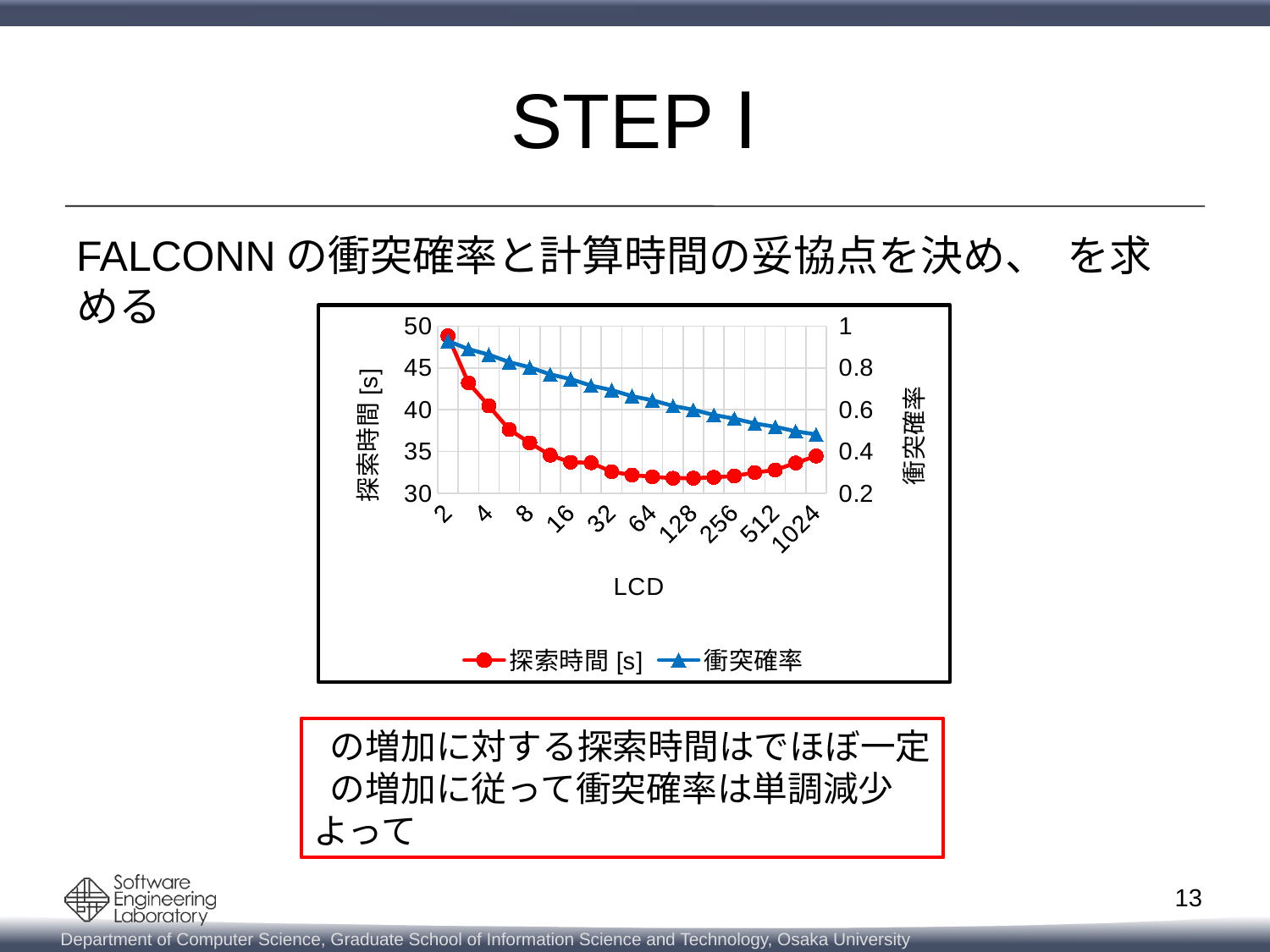
Is the 衝突確率 value at LCD = 1024 greater or less than 0.6? less Which is larger, the 探索時間 [s] value at LCD = 2 or at LCD = 1024? LCD = 2 Is the 探索時間 [s] value at LCD = 2 greater or less than 45? greater At which LCD value is 衝突確率 lowest? 1024 What is the title of the x axis of the chart? LCD At which LCD value is 探索時間 [s] highest? 2 Is the 探索時間 [s] value at LCD = 64 greater or less than 35? less What are the two series named in the chart legend? 探索時間 [s] and 衝突確率 Does the 衝突確率 series rise or fall as LCD increases along the x axis? fall How many tick labels are shown on the x axis of the chart? 10 What kind of chart is shown on the slide? line chart How many series does the chart legend list? 2